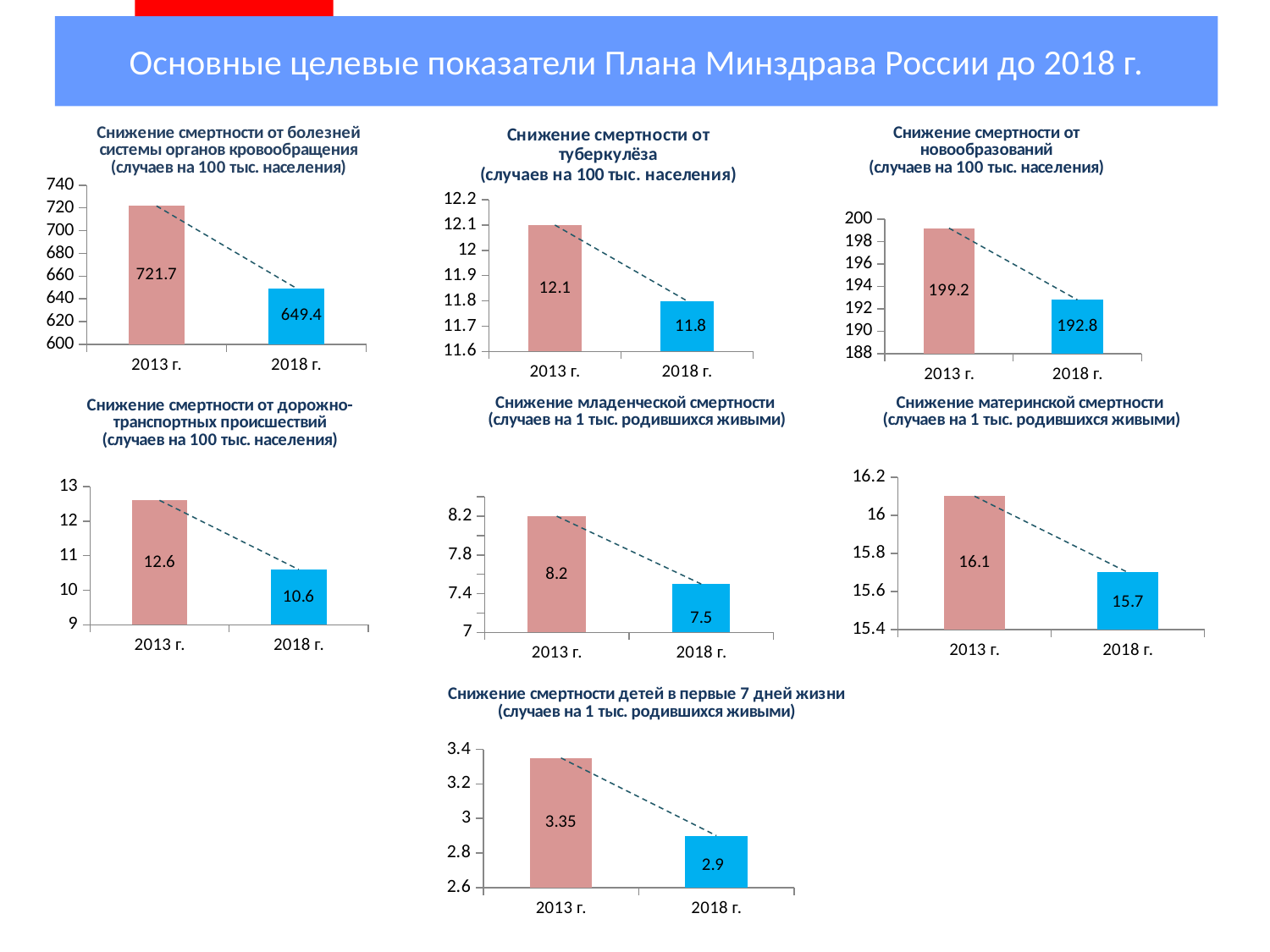
In the chart 'Снижение младенческой смертности', what is the value for 2013 г.? 8.2 In the chart 'Снижение смертности от дорожно-транспортных происшествий', what is the difference between the 2013 г. and 2018 г. values? 2.0 How many categories are shown on the x axis of the chart 'Снижение смертности от туберкулёза'? 2 In the chart 'Снижение смертности от дорожно-транспортных происшествий', which year has the lower value? 2018 г. In the chart 'Снижение смертности детей в первые 7 дней жизни', what is the value for 2013 г.? 3.35 In the chart 'Снижение смертности детей в первые 7 дней жизни', do the values rise or fall from 2013 г. to 2018 г.? fall In the chart 'Снижение смертности от болезней системы органов кровообращения', what is the value for 2013 г.? 721.7 In the chart 'Снижение смертности от болезней системы органов кровообращения', what is the value for 2018 г.? 649.4 What kind of chart is 'Снижение смертности от дорожно-транспортных происшествий'? bar chart In the chart 'Снижение материнской смертности', which value is larger, 2013 г. or 2018 г.? 2013 г. In the chart 'Снижение смертности от туберкулёза', what is the value for 2018 г.? 11.8 In the chart 'Снижение смертности от новообразований', what is the difference between the 2013 г. and 2018 г. values? 6.4